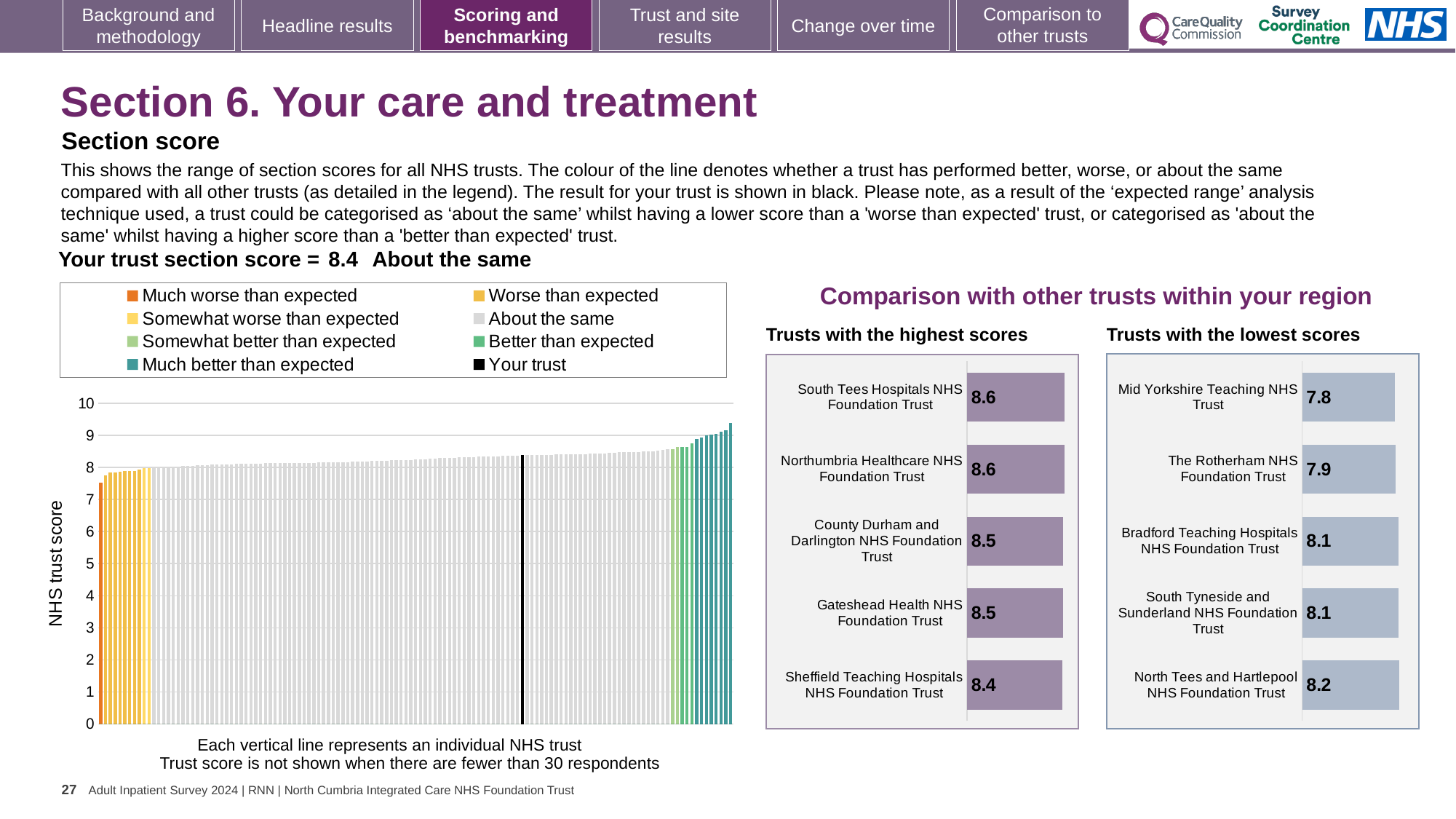
In the large chart on the left showing the range of section scores, what is the section score for your trust? 8.4 In the 'Trusts with the highest scores' chart, what is the score for Gateshead Health NHS Foundation Trust? 8.5 In the 'Trusts with the lowest scores' chart, what is the difference between the scores of North Tees and Hartlepool NHS Foundation Trust and Mid Yorkshire Teaching NHS Trust? 0.4 How many trusts are listed in the 'Trusts with the highest scores' chart? 5 In the 'Trusts with the lowest scores' chart, which has the higher score: The Rotherham NHS Foundation Trust or Bradford Teaching Hospitals NHS Foundation Trust? Bradford Teaching Hospitals NHS Foundation Trust In the large chart on the left showing the range of section scores, how many entries does the legend list? 8 In the 'Trusts with the highest scores' chart, which trust has the lowest score shown? Sheffield Teaching Hospitals NHS Foundation Trust In the 'Trusts with the lowest scores' chart, which trust has the lowest score? Mid Yorkshire Teaching NHS Trust In the 'Trusts with the lowest scores' chart, which trust has the highest score shown? North Tees and Hartlepool NHS Foundation Trust What kind of chart is the large chart on the left showing the range of section scores? Bar chart In the 'Trusts with the highest scores' chart, what is the difference between the scores of South Tees Hospitals NHS Foundation Trust and Sheffield Teaching Hospitals NHS Foundation Trust? 0.2 In the 'Trusts with the lowest scores' chart, what is the score for The Rotherham NHS Foundation Trust? 7.9